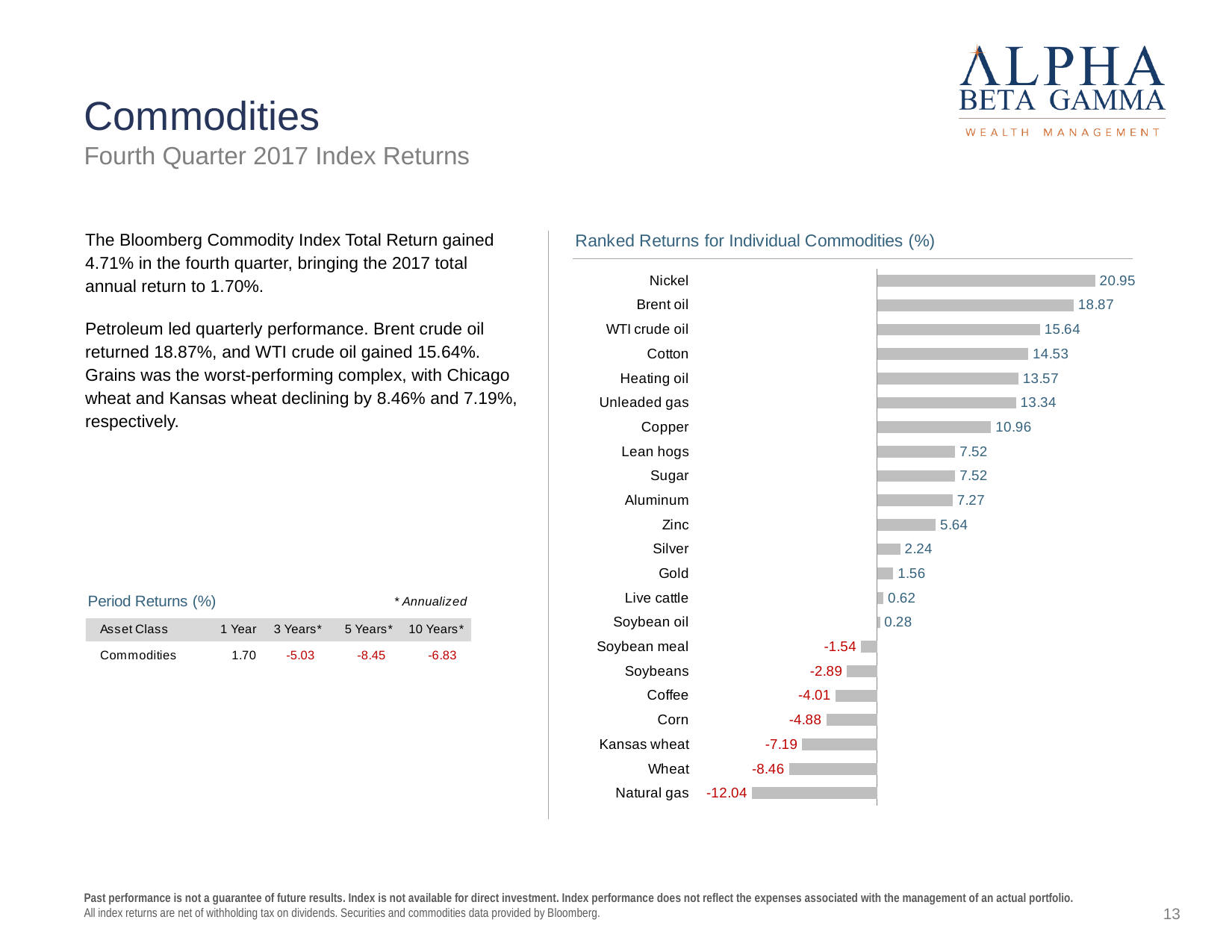
Which has the higher return, Cotton or Heating oil? Cotton Which commodity has the highest return in the chart? Nickel How many commodities are shown in the Ranked Returns for Individual Commodities chart? 22 What is the value for Zinc in the Ranked Returns for Individual Commodities chart? 5.64 What is the difference between the returns for Nickel and Brent oil? 2.08 What is the value for Natural gas in the Ranked Returns for Individual Commodities chart? -12.04 What is the value for Copper in the Ranked Returns for Individual Commodities chart? 10.96 What kind of chart is used to show the ranked returns for individual commodities? Bar chart What is the title of the chart on the slide? Ranked Returns for Individual Commodities (%) Which commodity has the lowest return in the chart? Natural gas What is the difference between the returns for Kansas wheat and Wheat? 1.27 How many commodities in the chart have a negative return? 7